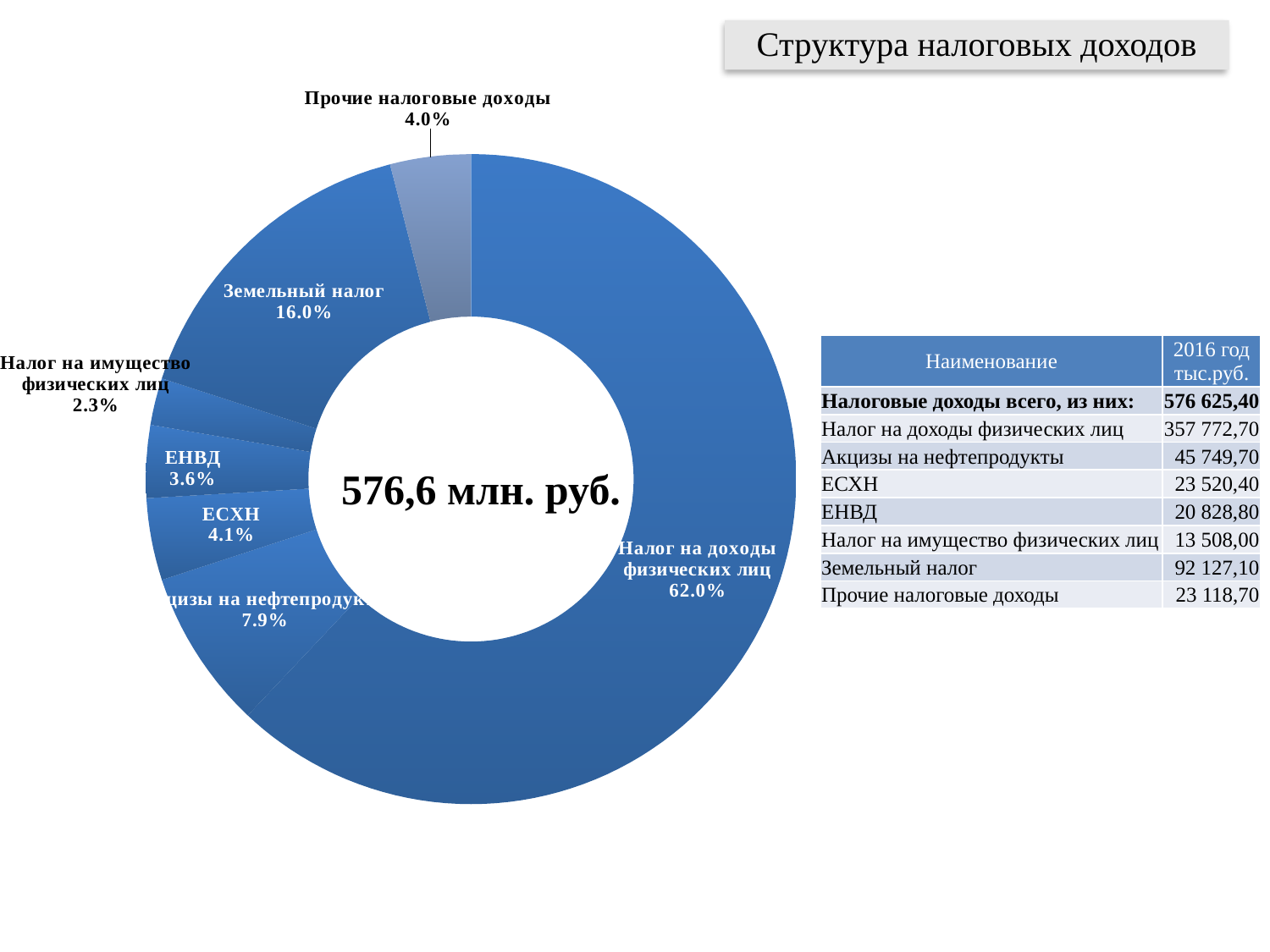
What percentage is shown for "ЕСХН" in the chart? 4.1% By how many percentage points does the share of "Земельный налог" exceed that of "Прочие налоговые доходы"? 12.0 percentage points Which has a larger share in the chart, "Акцизы на нефтепродукты" or "Земельный налог"? Земельный налог Which has a larger share in the chart, "ЕСХН" or "ЕНВД"? ЕСХН What percentage is shown for "Земельный налог" in the chart? 16.0% How many slices does the chart have? 7 Which category has the largest share in the chart? Налог на доходы физических лиц What share of tax revenues does "Налог на доходы физических лиц" account for in the chart? 62.0% Which category has the smallest share in the chart? Налог на имущество физических лиц What percentage is shown for "Прочие налоговые доходы" in the chart? 4.0% What kind of chart is shown on the slide? pie chart (donut) What total amount is printed in the centre of the chart? 576,6 млн. руб.